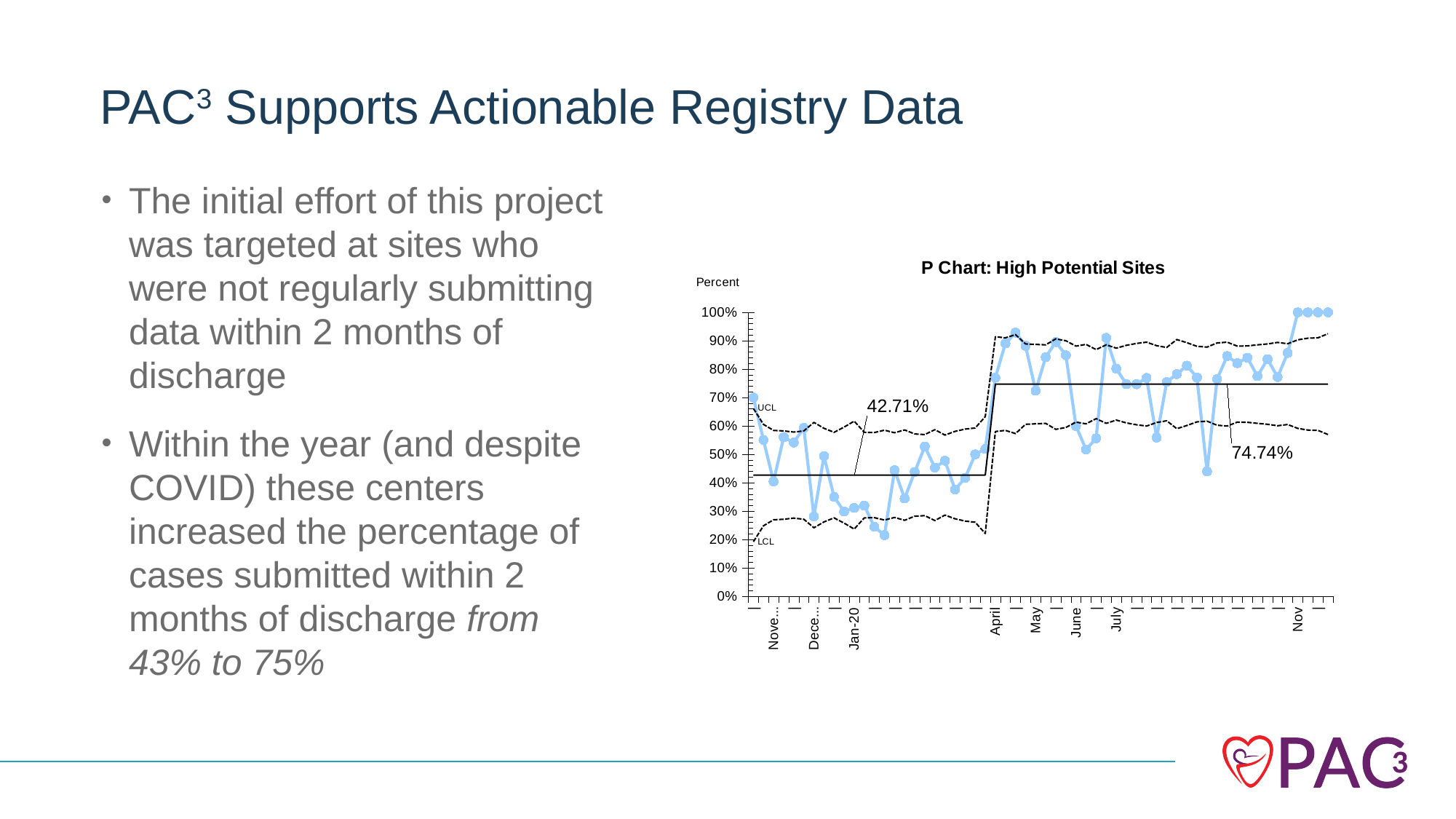
Which labelled center line value is larger, the one before April or the one after April? the one after April (74.74%) Do the plotted values generally rise or fall from the start of the chart to the end? rise Is the lowest plotted point on the chart, near Jan-20, greater or less than 30%? less What is the label on the vertical axis of the chart? Percent Are the plotted values at the far right of the chart (after Nov) greater or less than 90%? greater What is the title of the chart? P Chart: High Potential Sites What kind of chart is shown on the slide? line chart What value is labelled on the center line before the shift in April? 42.71% What value is labelled on the center line after the shift in April? 74.74% What is the difference between the two labelled center line values, 74.74% and 42.71%? 32.03 percentage points What is the highest value shown on the vertical axis? 100%